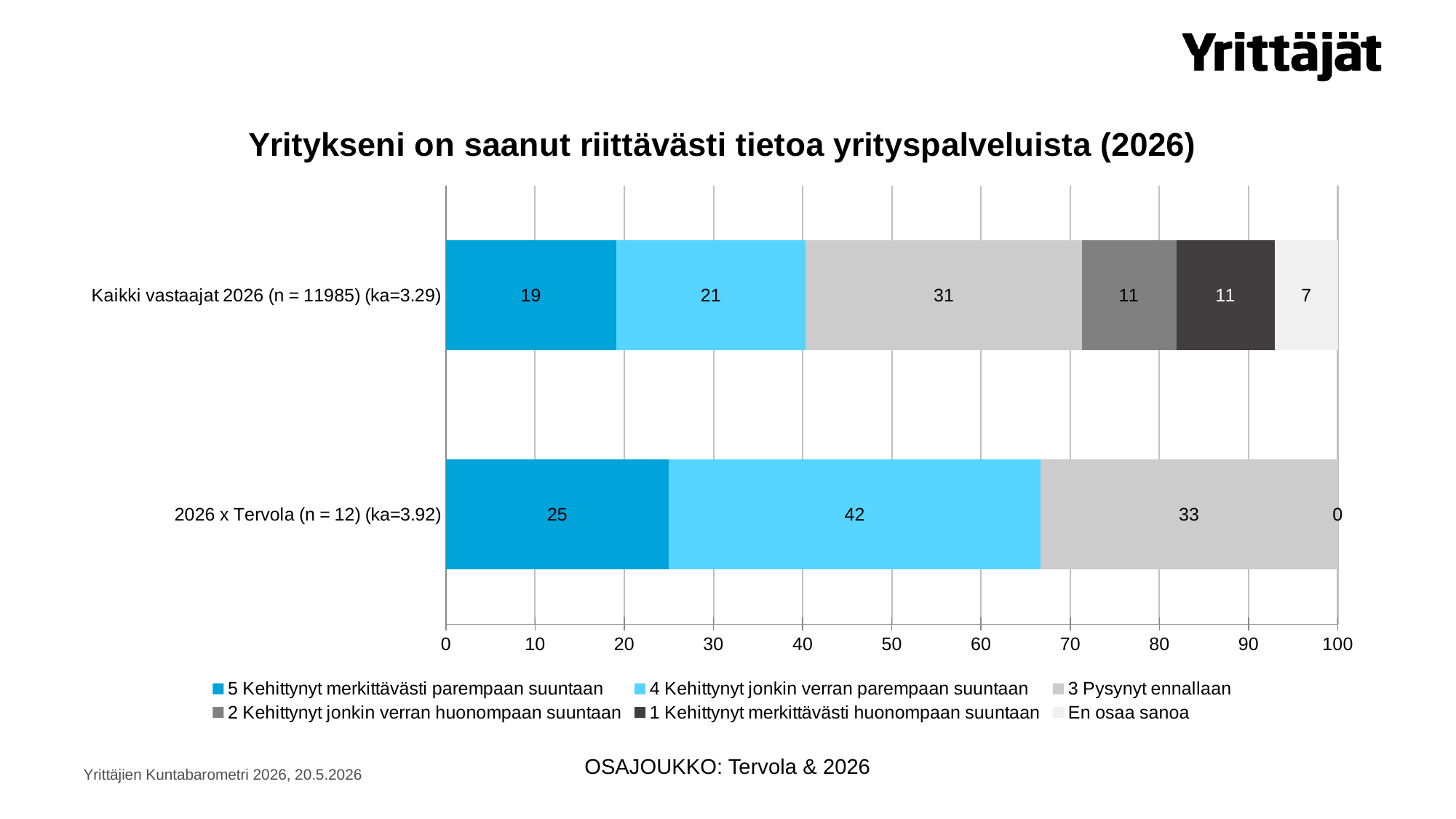
What is the value of '3 Pysynyt ennallaan' for '2026 x Tervola (n = 12) (ka=3.92)'? 33 How many categories (bars) are shown in the chart? 2 How many series does the legend list? 6 What is the title of the chart? Yritykseni on saanut riittävästi tietoa yrityspalveluista (2026) Which series has the largest value in the '2026 x Tervola (n = 12) (ka=3.92)' bar? 4 Kehittynyt jonkin verran parempaan suuntaan What is the value of '4 Kehittynyt jonkin verran parempaan suuntaan' for '2026 x Tervola (n = 12) (ka=3.92)'? 42 What type of chart is shown on the slide? Stacked bar chart What is the value of '3 Pysynyt ennallaan' for 'Kaikki vastaajat 2026 (n = 11985) (ka=3.29)'? 31 What is the difference between the '4 Kehittynyt jonkin verran parempaan suuntaan' values for '2026 x Tervola' and 'Kaikki vastaajat 2026'? 21 Which category has the higher value for '5 Kehittynyt merkittävästi parempaan suuntaan', 'Kaikki vastaajat 2026' or '2026 x Tervola'? 2026 x Tervola What is the value of 'En osaa sanoa' for 'Kaikki vastaajat 2026 (n = 11985) (ka=3.29)'? 7 What is the value of '5 Kehittynyt merkittävästi parempaan suuntaan' for 'Kaikki vastaajat 2026 (n = 11985) (ka=3.29)'? 19